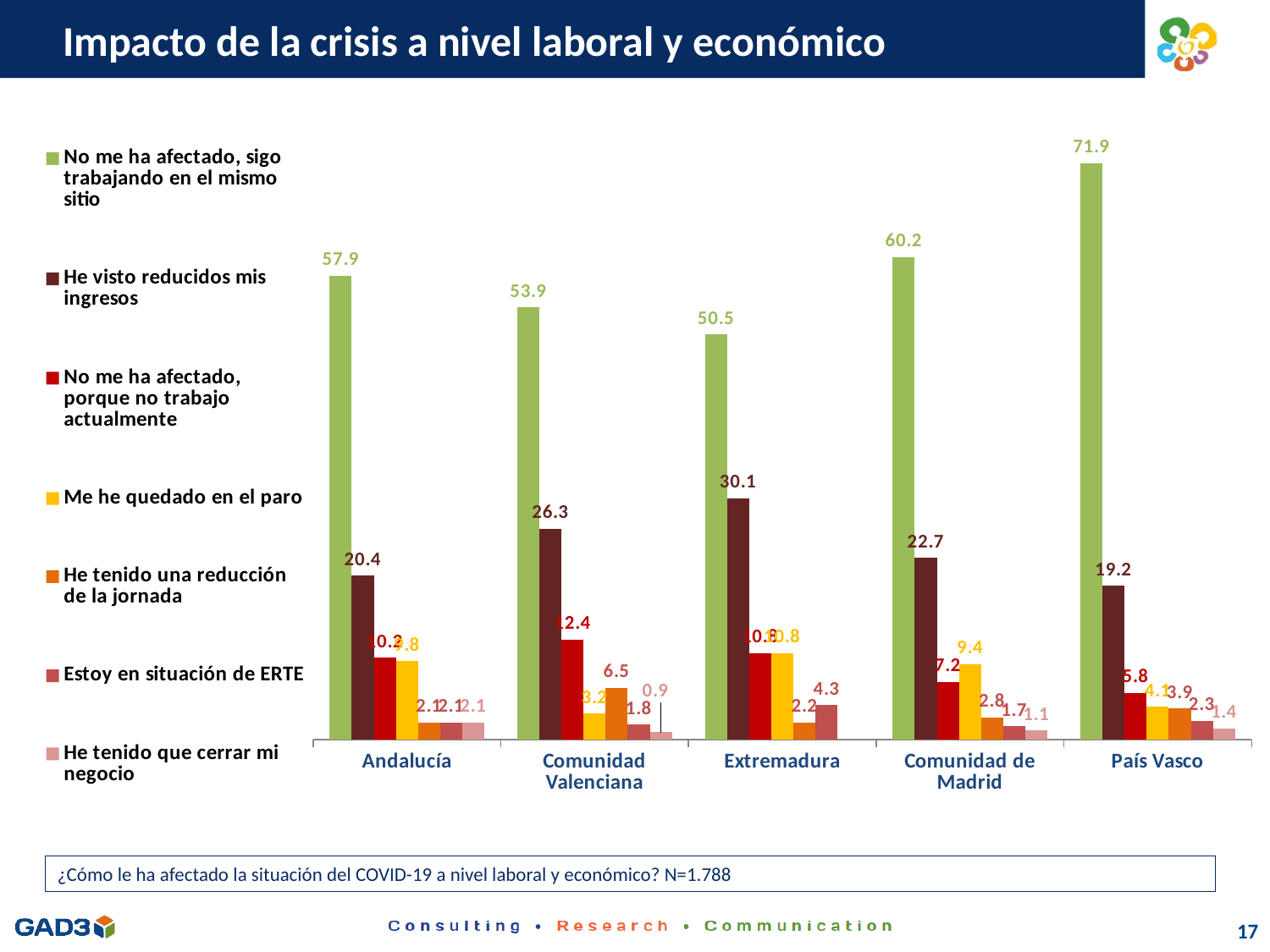
What is the value for "Me he quedado en el paro" in Comunidad de Madrid? 9.4 How many regions are shown on the x axis? 5 What is the value for "He tenido una reducción de la jornada" in Comunidad Valenciana? 6.5 What is the value for "He visto reducidos mis ingresos" in Extremadura? 30.1 Which is larger: "He visto reducidos mis ingresos" in Comunidad Valenciana or in Comunidad de Madrid? Comunidad Valenciana What is the value for "Estoy en situación de ERTE" in Extremadura? 4.3 What is the difference between the "No me ha afectado, sigo trabajando en el mismo sitio" values for País Vasco and Andalucía? 14.0 Which region has the lowest value for "No me ha afectado, sigo trabajando en el mismo sitio"? Extremadura What is the value for "No me ha afectado, sigo trabajando en el mismo sitio" in País Vasco? 71.9 Which region has the highest value for "No me ha afectado, sigo trabajando en el mismo sitio"? País Vasco What kind of chart is shown on the slide? Bar chart How many series does the legend list? 7